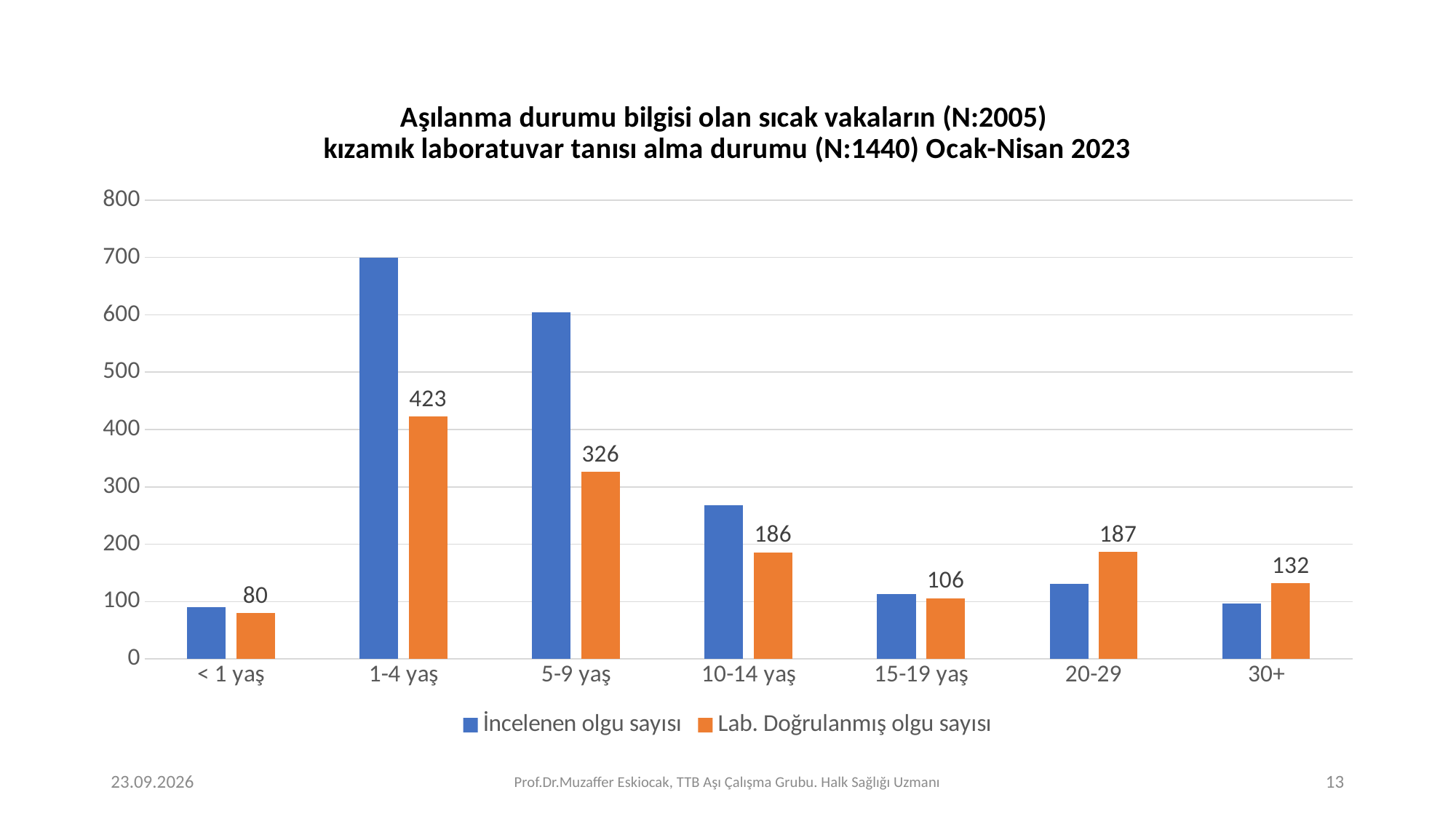
What is the Lab. Doğrulanmış olgu sayısı value for the 15-19 yaş group? 106 Is the İncelenen olgu sayısı value for 1-4 yaş greater or less than 600? greater Is the İncelenen olgu sayısı value for 15-19 yaş greater or less than 200? less Which age group has the highest Lab. Doğrulanmış olgu sayısı? 1-4 yaş Which age group has the lowest Lab. Doğrulanmış olgu sayısı? < 1 yaş What is the Lab. Doğrulanmış olgu sayısı value for the 1-4 yaş group? 423 What is the difference between the Lab. Doğrulanmış olgu sayısı values for 1-4 yaş and 5-9 yaş? 97 What kind of chart is shown on the slide? bar chart What is the Lab. Doğrulanmış olgu sayısı value for the 30+ group? 132 How many age groups are shown on the x axis? 7 Which has a larger Lab. Doğrulanmış olgu sayısı, 5-9 yaş or 10-14 yaş? 5-9 yaş How many series does the legend list? 2